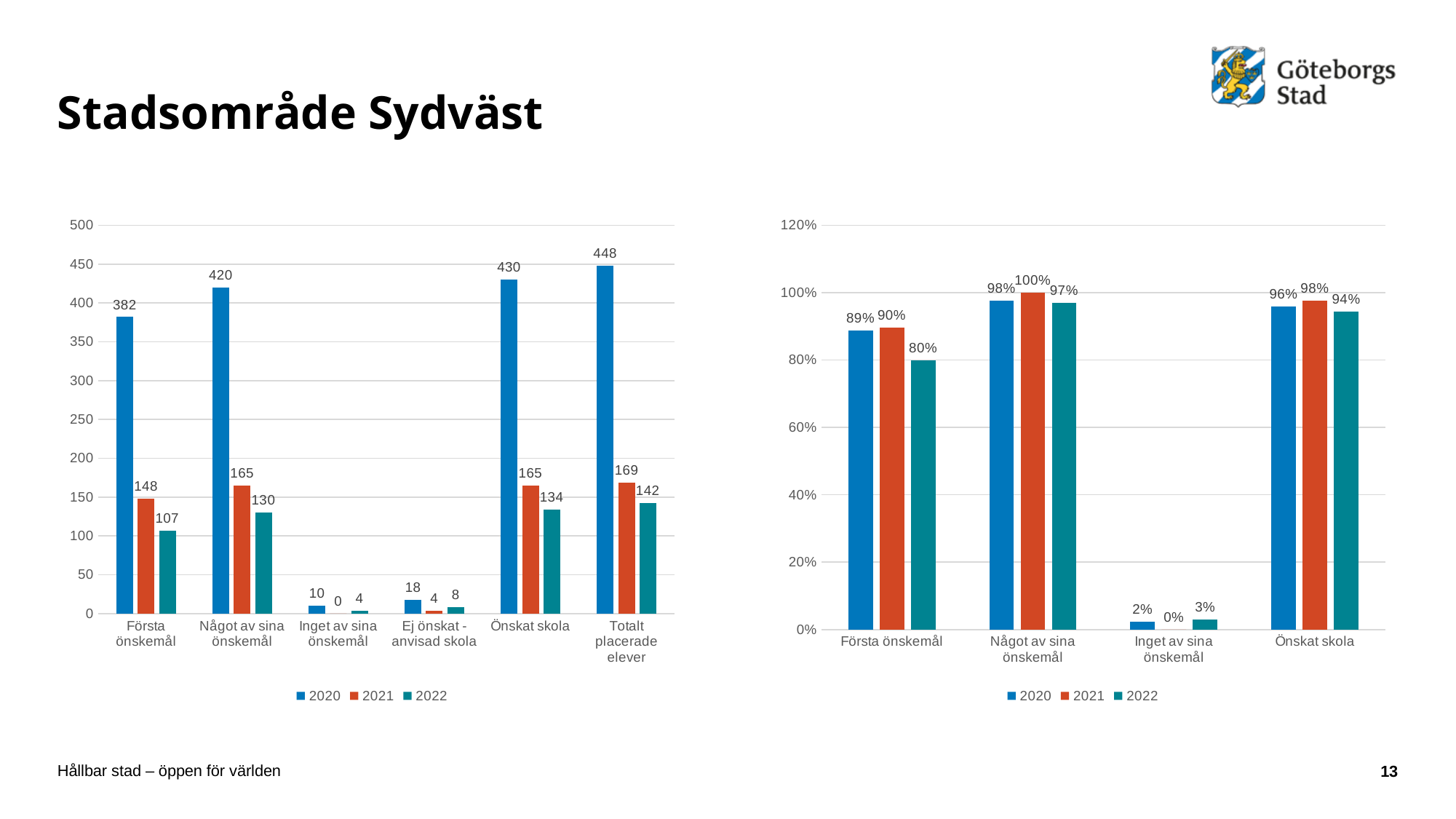
How many series does the legend of the left chart list? 3 In the right chart, what is the value for 2021 in the 'Något av sina önskemål' category? 100% What kind of chart is the left chart? Bar chart In the right chart, which is larger for 'Önskat skola': the 2020 value or the 2022 value? 2020 How many categories are shown on the x axis of the right chart? 4 In the left chart, which category has the highest value for the 2020 series? Totalt placerade elever In the left chart, what is the value for 2020 in the 'Totalt placerade elever' category? 448 In the right chart, what is the difference between the 2021 and 2022 values for 'Första önskemål'? 10% In the left chart, what is the value for 2022 in the 'Första önskemål' category? 107 In the left chart, which category has the lowest value for the 2021 series? Inget av sina önskemål In the right chart, what is the value for 2022 in the 'Första önskemål' category? 80% In the left chart, what is the difference between the 2020 and 2021 values for 'Önskat skola'? 265